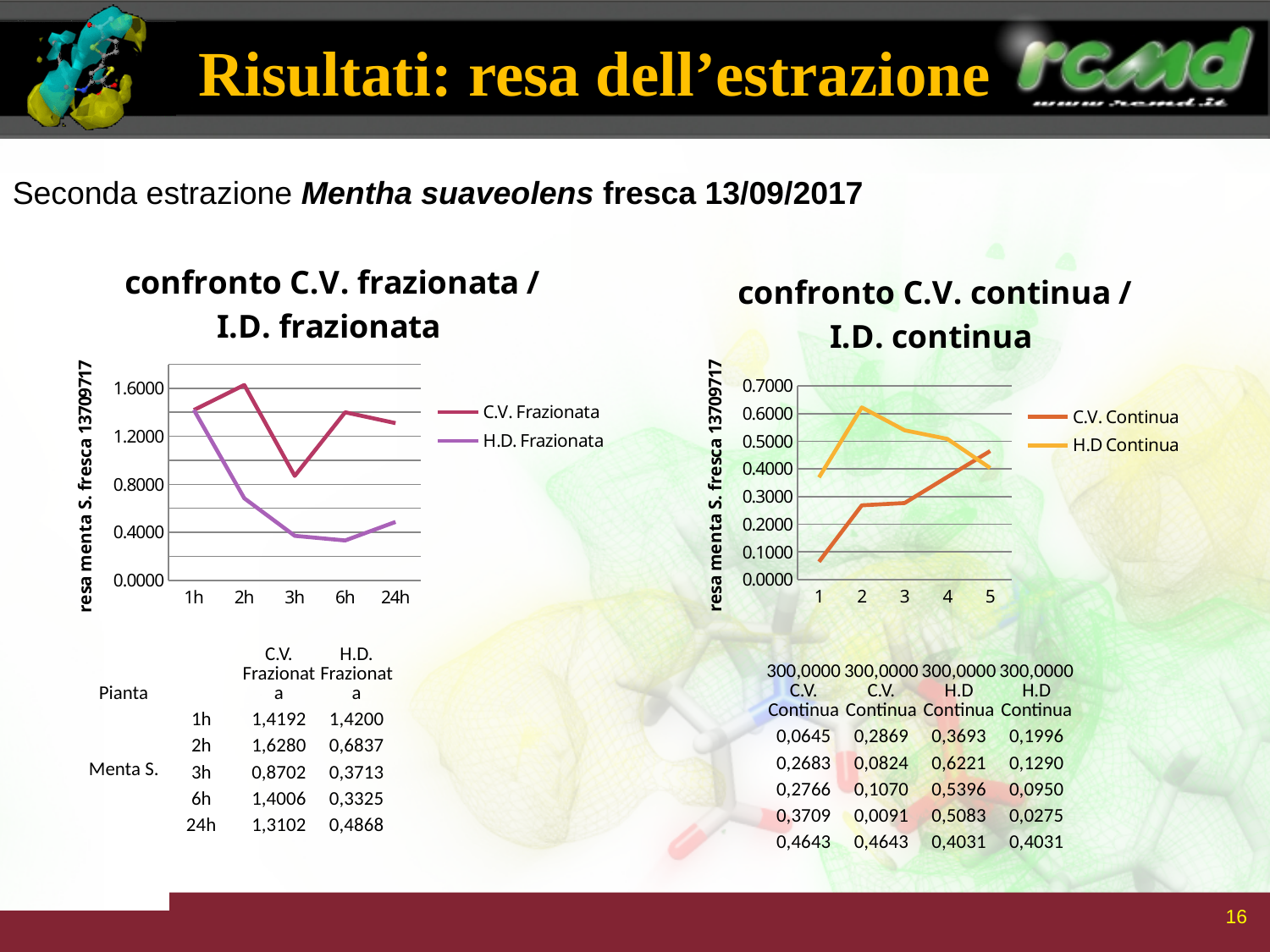
In the 'confronto C.V. continua / I.D. continua' chart, is the value of H.D Continua at point 2 greater or less than 0.5000? greater In the 'confronto C.V. frazionata / I.D. frazionata' chart, at which time point is C.V. Frazionata highest? 2h In the 'confronto C.V. frazionata / I.D. frazionata' chart, which series has the larger value at 3h, C.V. Frazionata or H.D. Frazionata? C.V. Frazionata How many points are plotted along the x axis of the 'confronto C.V. continua / I.D. continua' chart? 5 In the 'confronto C.V. continua / I.D. continua' chart, does the C.V. Continua series generally rise or fall from point 1 to point 5? rise In the 'confronto C.V. frazionata / I.D. frazionata' chart, what is the value of C.V. Frazionata at 2h? 1,6280 In the 'confronto C.V. frazionata / I.D. frazionata' chart, what is the difference between C.V. Frazionata and H.D. Frazionata at 2h? 0,9443 What kind of chart is the 'confronto C.V. frazionata / I.D. frazionata' chart? line chart How many series does the legend of the 'confronto C.V. continua / I.D. continua' chart list? 2 In the 'confronto C.V. frazionata / I.D. frazionata' chart, what is the value of H.D. Frazionata at 6h? 0,3325 In the 'confronto C.V. frazionata / I.D. frazionata' chart, at which time point is H.D. Frazionata lowest? 6h What is the y-axis label of the 'confronto C.V. continua / I.D. continua' chart? resa menta S. fresca 13709717